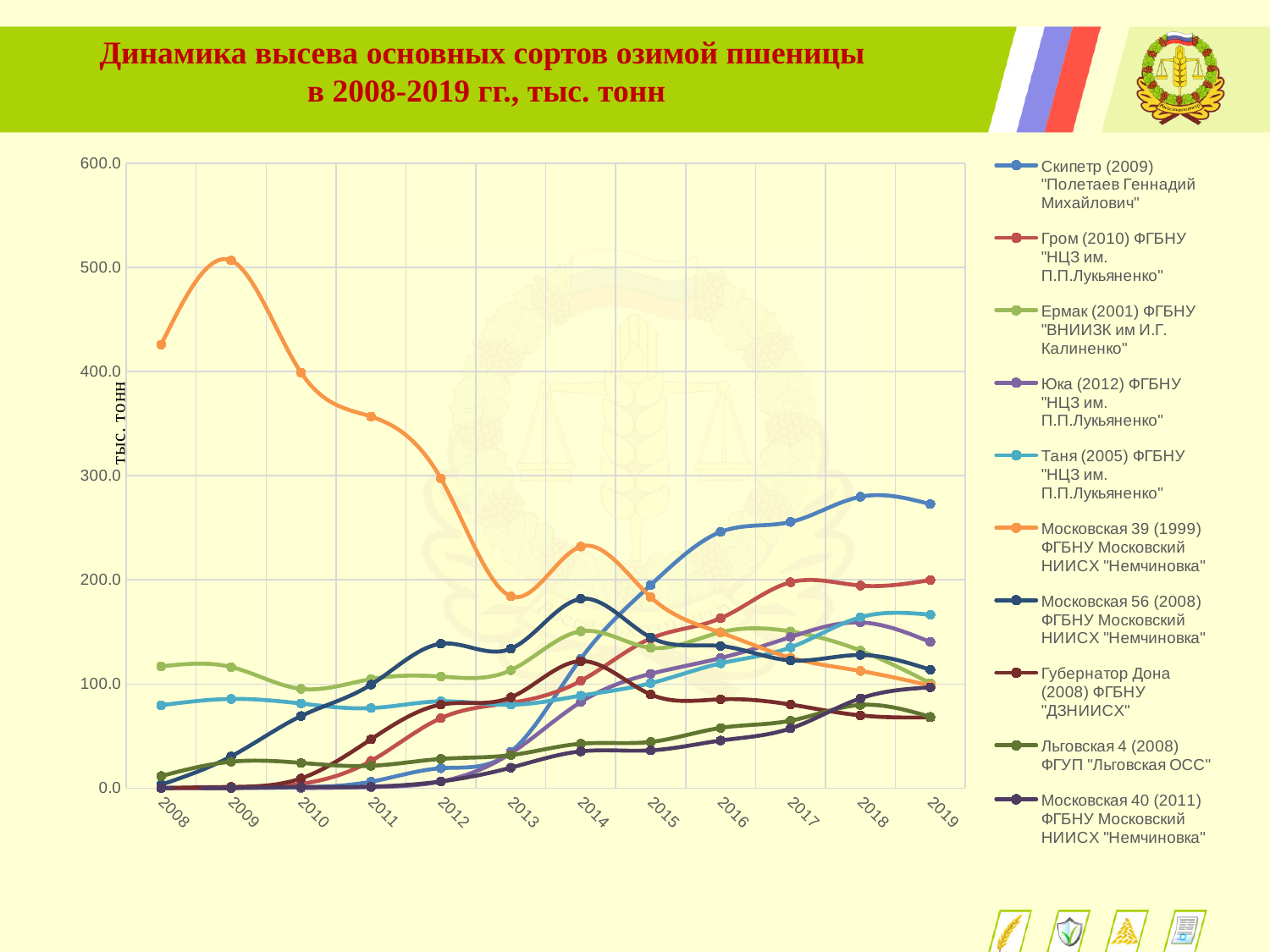
Is the value for Московская 39 (1999) in 2008 greater or less than 400? greater In 2019, which is larger: Скипетр (2009) or Гром (2010)? Скипетр (2009) Is the value for Ермак (2001) in 2008 greater or less than 100? greater What kind of chart is shown on the slide? line chart Is the value for Скипетр (2009) in 2018 greater or less than 250? greater Does the value for Московская 39 (1999) rise or fall from 2009 to 2013? fall What is the label on the y axis? тыс. тонн How many years are shown along the x axis? 12 Which variety had the highest value in 2014? Московская 39 (1999) Which variety had the highest value in 2009? Московская 39 (1999) Which variety had the highest value in 2019? Скипетр (2009) How many series does the legend list? 10